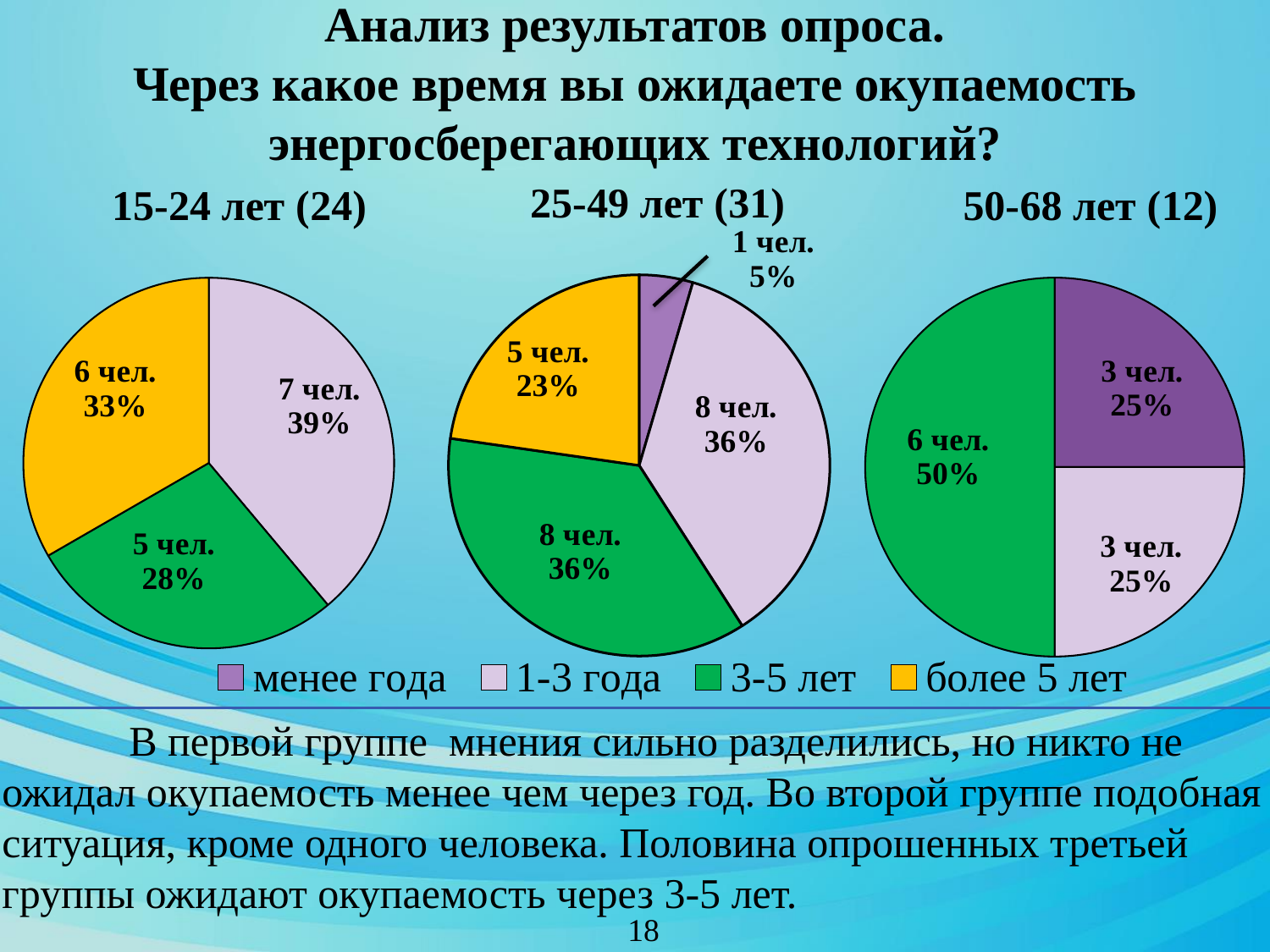
In the chart titled '15-24 лет (24)', how many people chose 'более 5 лет'? 6 чел. How many series does the legend list? 4 In the chart titled '50-68 лет (12)', which category has the largest slice? 3-5 лет What type of charts are shown on the slide? Pie charts In the chart titled '25-49 лет (31)', how many slices does the pie have? 4 In the chart titled '15-24 лет (24)', which category has the smallest slice? 3-5 лет In the chart titled '50-68 лет (12)', what share of respondents chose '3-5 лет'? 50% In the chart titled '25-49 лет (31)', what share of respondents chose 'менее года'? 5% In the chart titled '15-24 лет (24)', what share of respondents chose '1-3 года'? 39% Which colour represents 'более 5 лет' in the legend? Yellow In the chart titled '25-49 лет (31)', how many people chose 'более 5 лет'? 5 чел. In the chart titled '50-68 лет (12)', what is the difference in number of people between '3-5 лет' and 'менее года'? 3 чел.